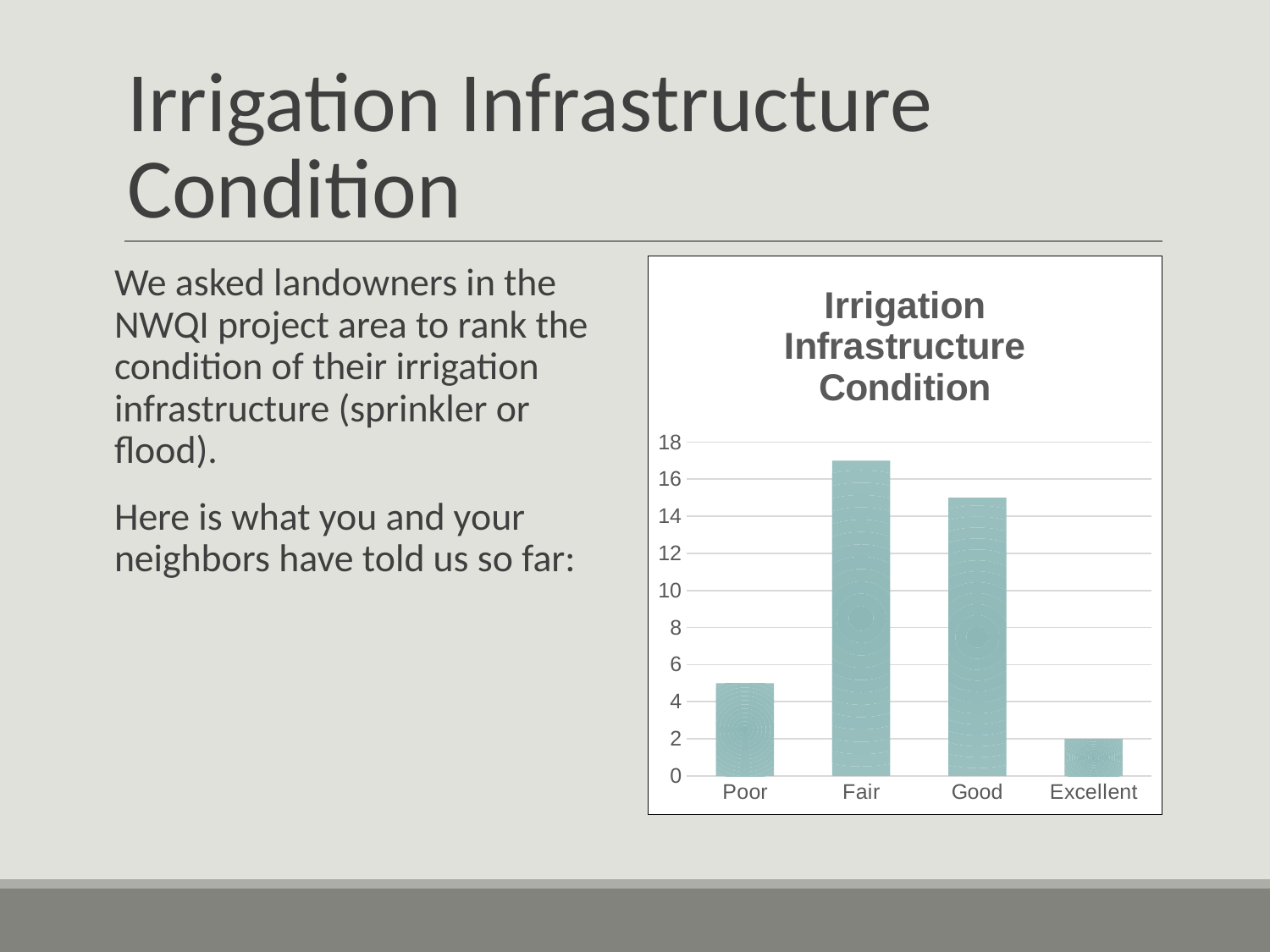
Which category has the highest bar in the chart? Fair Is the value for Good greater or less than 14? greater Which category has the lowest bar in the chart? Excellent Is the value for Excellent greater or less than 4? less How many categories are shown on the x axis of the chart? 4 Which is larger, the value for Fair or the value for Excellent? Fair What is the title of the chart? Irrigation Infrastructure Condition What kind of chart is shown on the slide? bar chart What is the highest value shown on the chart's vertical axis? 18 Which is larger, the value for Poor or the value for Good? Good Is the value for Fair greater or less than 16? greater